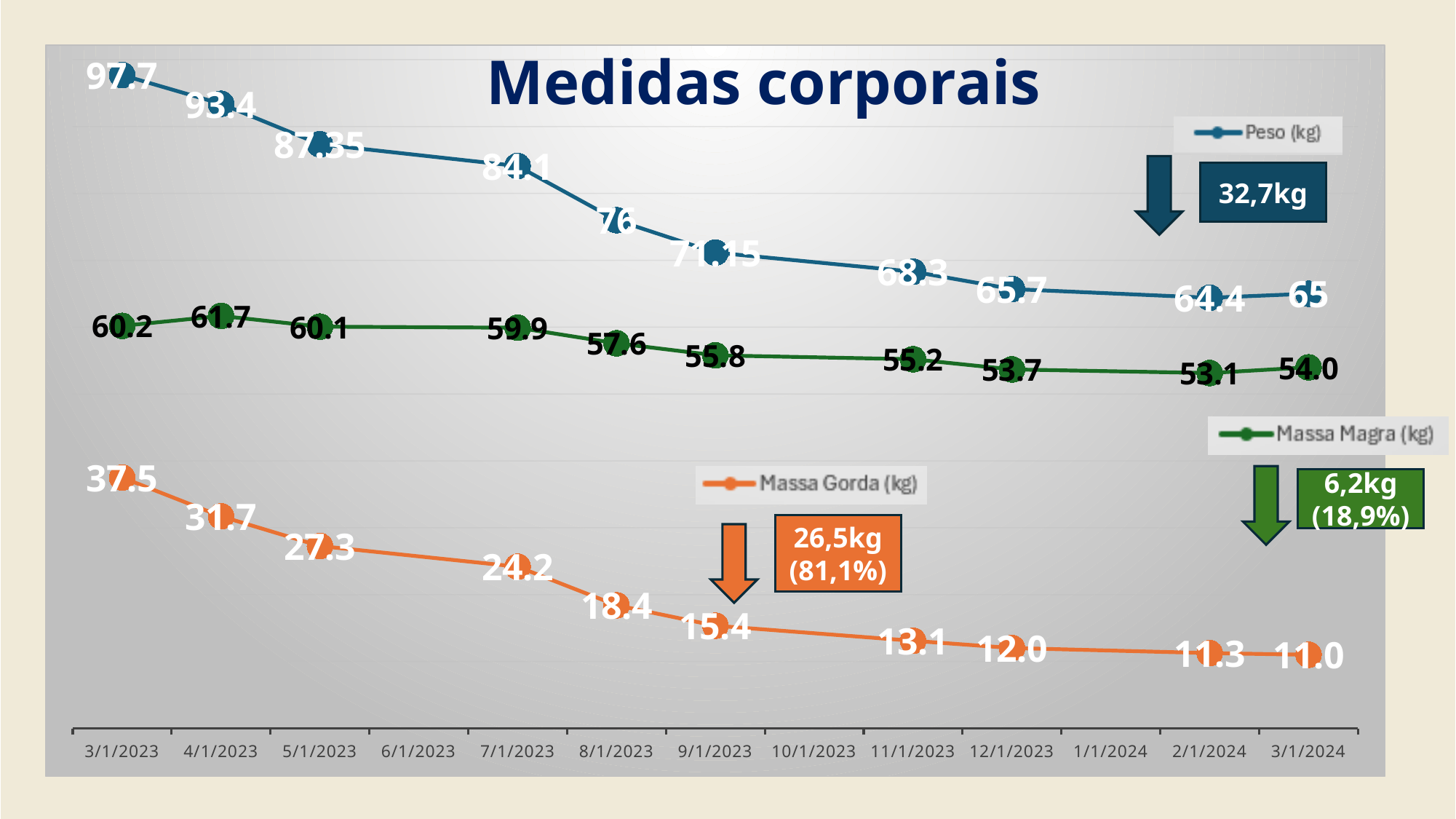
Which is larger: Massa Magra (kg) on 3/1/2023 or on 3/1/2024? 3/1/2023 What kind of chart is shown on the slide? Line chart What is the value of Massa Gorda (kg) on 3/1/2024? 11.0 What is the value of Massa Magra (kg) on 4/1/2023? 61.7 On which date is Massa Magra (kg) highest? 4/1/2023 By how much did Peso (kg) decrease from 3/1/2023 to 3/1/2024? 32.7 What is the value of Peso (kg) on 3/1/2023? 97.7 By how much did Massa Gorda (kg) decrease from 3/1/2023 to 3/1/2024? 26.5 Does Massa Gorda (kg) generally rise or fall over time? Fall On which date is Massa Gorda (kg) lowest? 3/1/2024 What is the value of Peso (kg) on 8/1/2023? 76 How many series does the chart show? 3